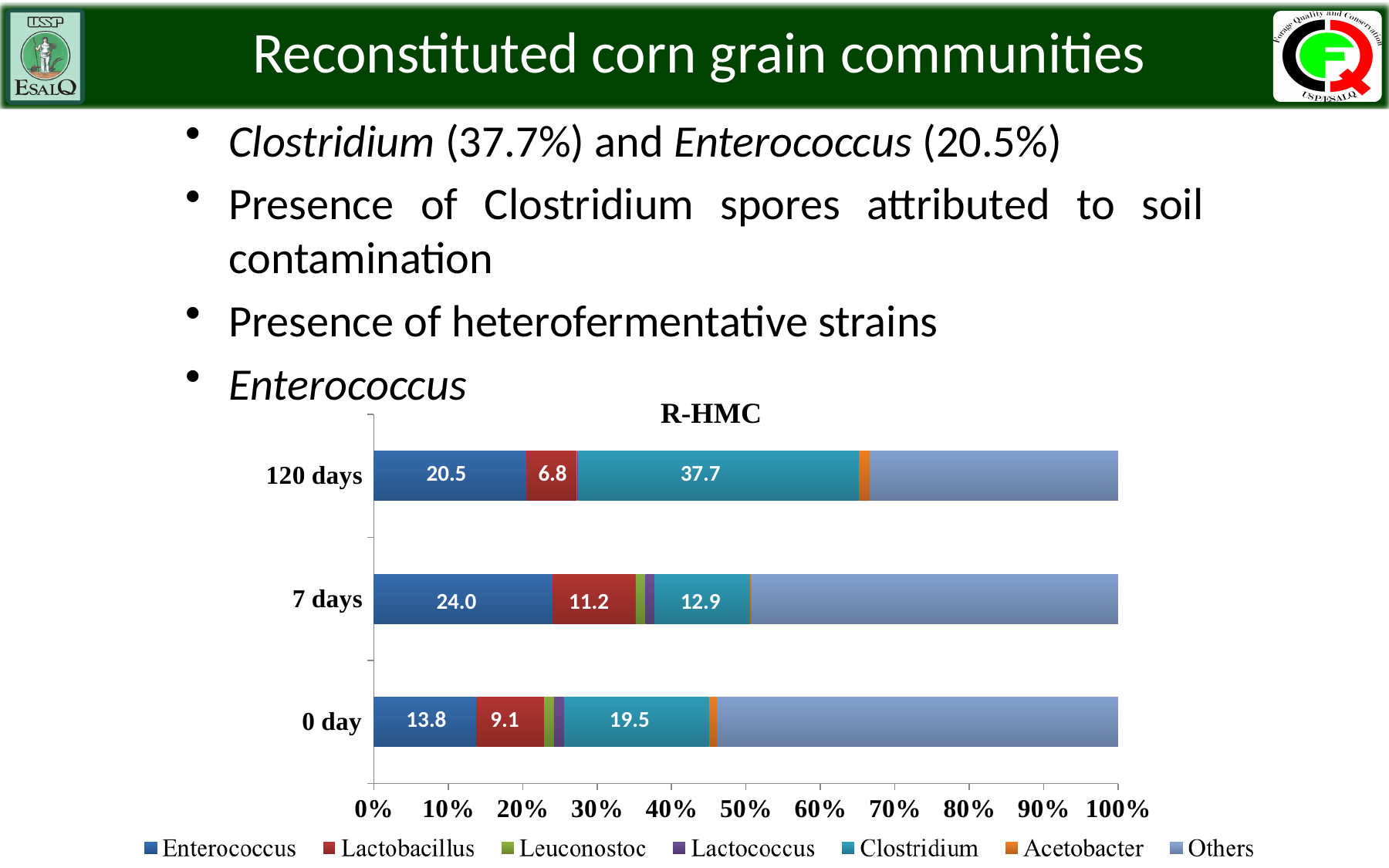
What is the difference between the Clostridium values for 120 days and 0 day? 18.2 How many series does the legend list? 7 How many categories are shown on the y axis? 3 What is the Lactobacillus value for 0 day? 9.1 What is the Enterococcus value for 120 days? 20.5 What kind of chart is shown? stacked bar chart What is the title of the chart? R-HMC What is the Clostridium value for 7 days? 12.9 Is the Others share for 120 days greater or less than 30%? greater Which category has the lowest Enterococcus value? 0 day Which is larger, the Lactobacillus value for 7 days or for 120 days? 7 days Which category has the highest Clostridium value? 120 days